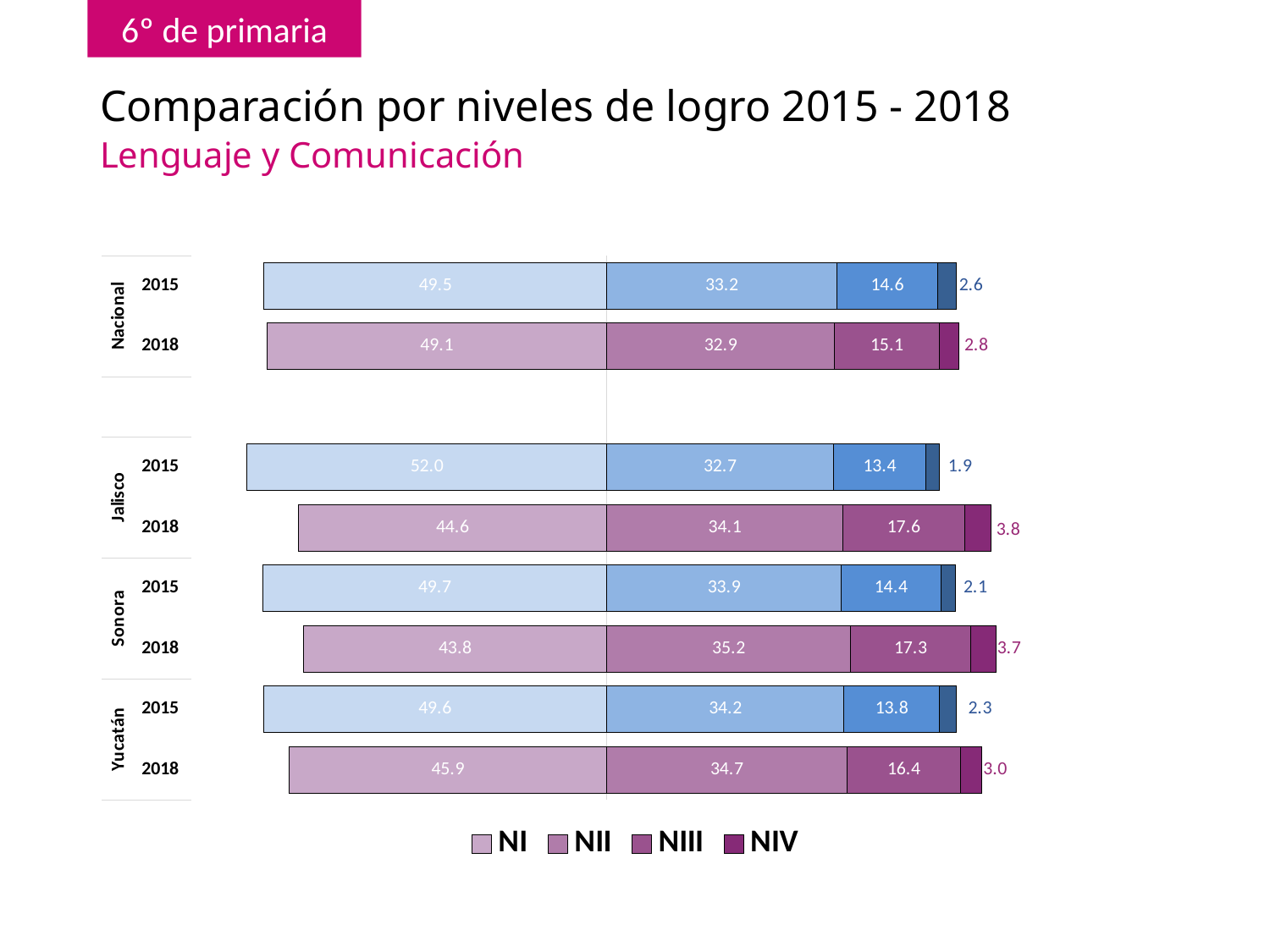
Which is larger, the NI value for Sonora in 2018 or for Yucatán in 2018? Yucatán 2018 What is the NIII value for Sonora in 2018? 17.3 What is the difference between the NIII value for Jalisco in 2018 and in 2015? 4.2 What type of chart is shown on the slide? Stacked bar chart What is the subtitle of the chart shown below the main title? Lenguaje y Comunicación Did the NI value for Sonora rise or fall from 2015 to 2018? Fall What is the NII value for Nacional in 2015? 33.2 How many series does the legend list? 4 Which bar has the lowest NIV value? Jalisco 2015 What is the NI value for Jalisco in 2015? 52.0 Which bar has the highest NI value? Jalisco 2015 What is the NIV value for Yucatán in 2018? 3.0